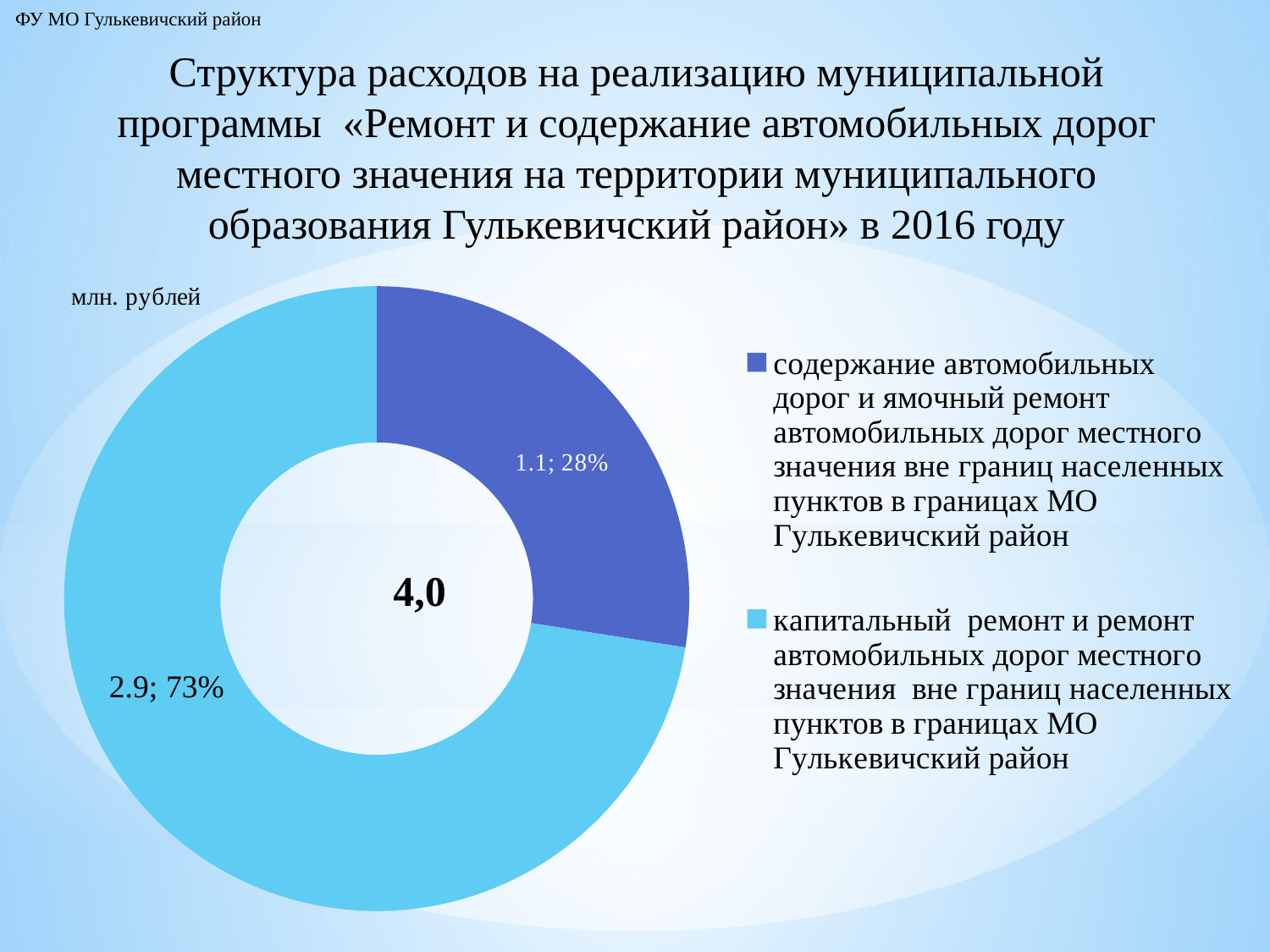
What share of the chart does the slice 'капитальный ремонт и ремонт автомобильных дорог...' represent? 73% Which category has the smallest slice in the chart? содержание автомобильных дорог и ямочный ремонт автомобильных дорог местного значения вне границ населенных пунктов в границах МО Гулькевичский район How many slices does the chart have? 2 What value is shown for the slice 'содержание автомобильных дорог и ямочный ремонт автомобильных дорог местного значения вне границ населенных пунктов в границах МО Гулькевичский район'? 1.1 What total value is shown in the centre of the chart? 4,0 What kind of chart is shown on the slide? doughnut chart Which category has the largest slice in the chart? капитальный ремонт и ремонт автомобильных дорог местного значения вне границ населенных пунктов в границах МО Гулькевичский район What share of the chart does the slice 'содержание автомобильных дорог и ямочный ремонт...' represent? 28% What value is shown for the slice 'капитальный ремонт и ремонт автомобильных дорог местного значения вне границ населенных пунктов в границах МО Гулькевичский район'? 2.9 What unit of measurement is indicated next to the chart? млн. рублей What is the difference between the values for 'капитальный ремонт и ремонт...' (2.9) and 'содержание автомобильных дорог и ямочный ремонт...' (1.1)? 1.8 Which is larger: the value for 'содержание автомобильных дорог и ямочный ремонт...' or the value for 'капитальный ремонт и ремонт...'? капитальный ремонт и ремонт...